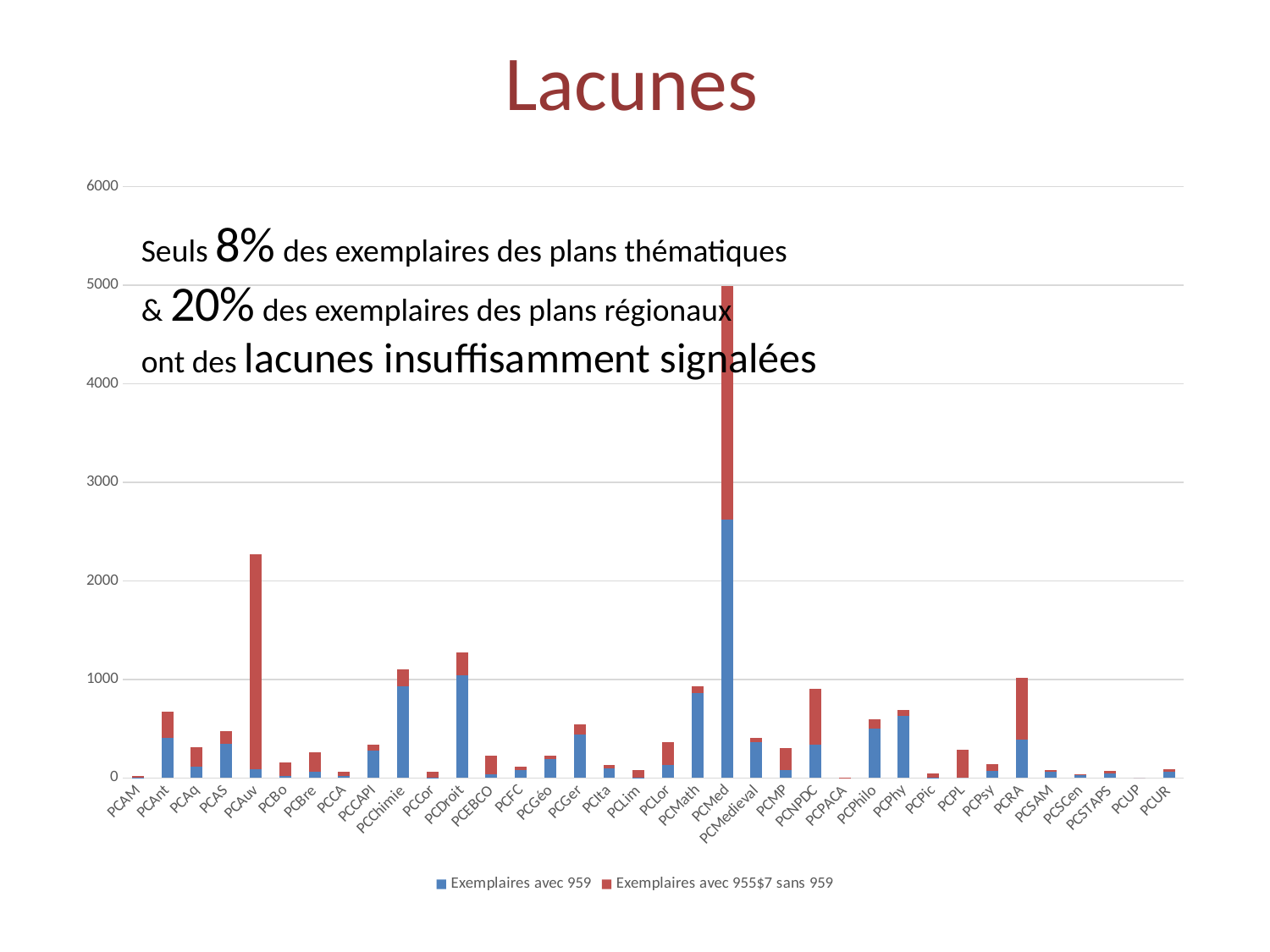
Which category has the tallest stacked bar? PCMed What is the title of the slide containing the chart? Lacunes Is the total stacked value for PCAuv greater or less than 2000? greater Is the total stacked value for PCMed greater or less than 4000? greater What kind of chart is shown on the slide? stacked bar chart Is the total stacked value for PCChimie greater or less than 1000? greater Which has the taller stacked bar, PCAuv or PCChimie? PCAuv Which has the taller stacked bar, PCMed or PCAuv? PCMed How many series does the legend list? 2 How many categories are shown on the x axis of the chart? 36 Which series is shown in red in the chart? Exemplaires avec 955$7 sans 959